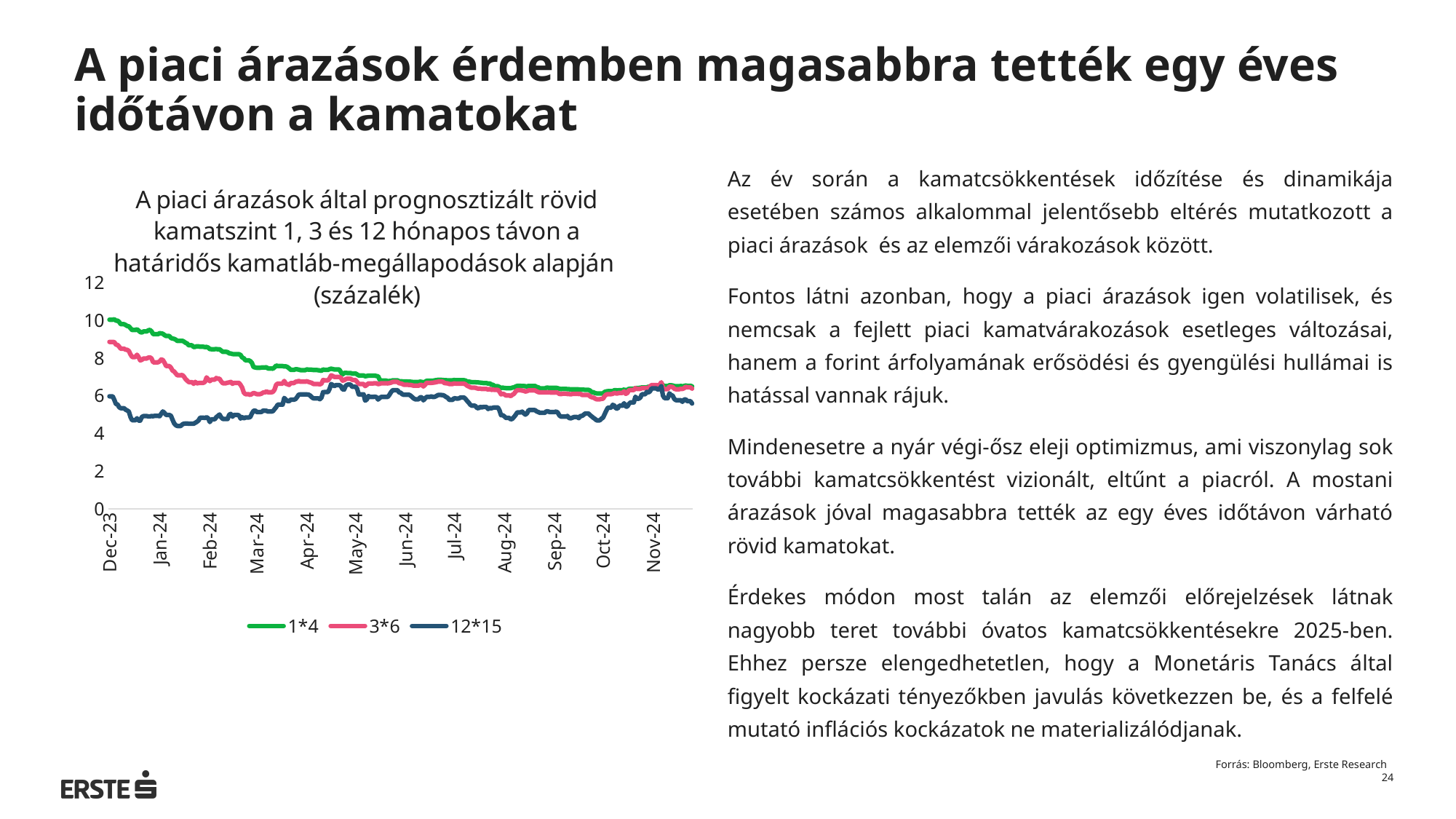
At Dec-23, which is larger: the 1*4 series or the 12*15 series? 1*4 Is the value of the 1*4 series at Dec-23 greater or less than 8? greater What is the highest value shown on the y axis of the chart? 12 How many month labels are shown on the x axis of the chart? 12 How many series does the chart legend list? 3 What colour is the line for the 12*15 series? dark blue What kind of chart is shown on the slide? line chart Is the value of the 12*15 series at Dec-23 greater or less than 8? less Which series has the highest value at Dec-23? 1*4 Which series has the lowest value at Dec-23? 12*15 Does the 1*4 series generally rise or fall from Dec-23 to Nov-24? fall Is the value of the 12*15 series at Feb-24 greater or less than 6? less